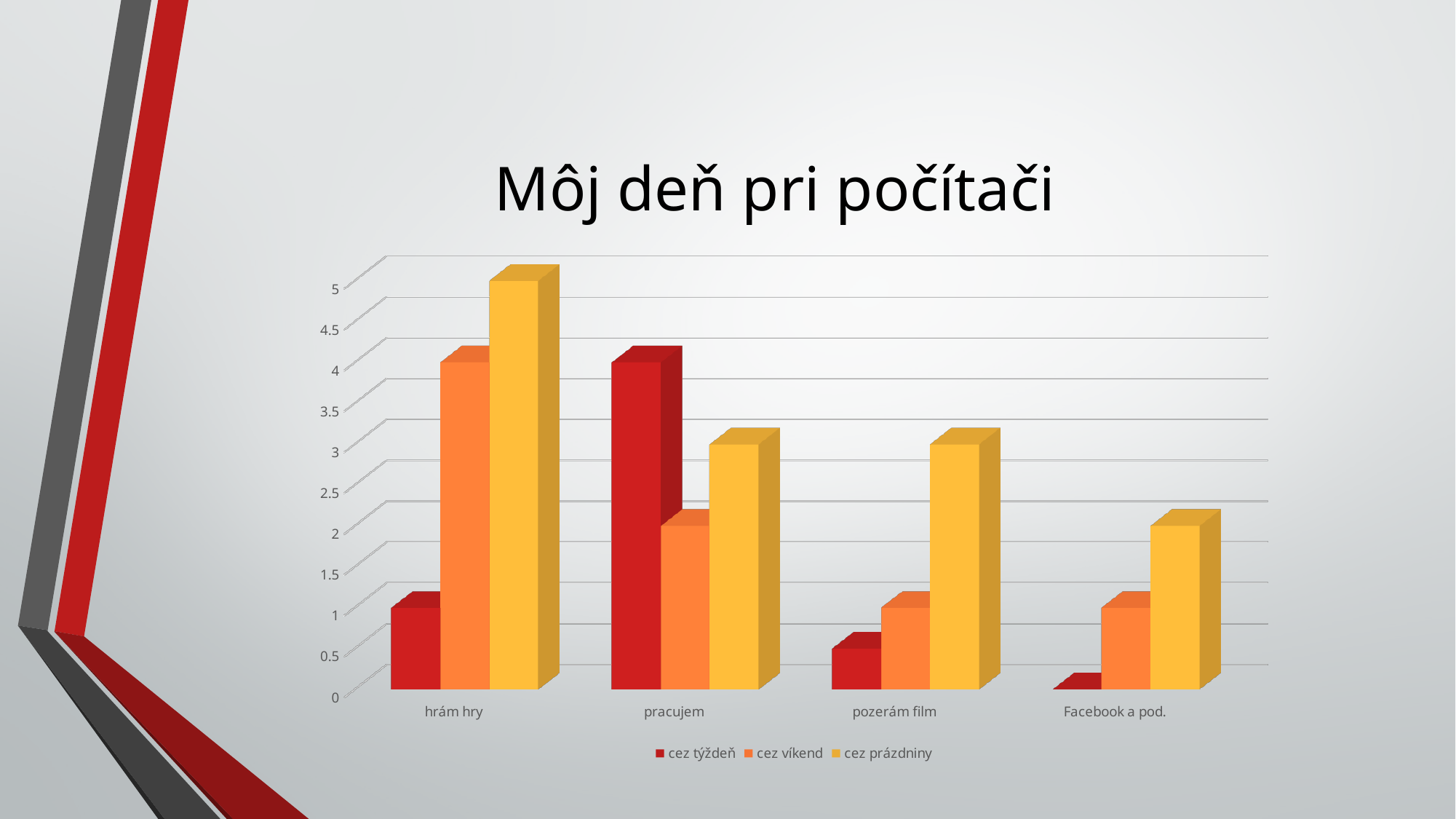
What kind of chart is shown on the slide? bar chart Is the value for 'cez víkend' in the 'pracujem' category greater or less than 3? less In the 'Facebook a pod.' category, which is larger: 'cez víkend' or 'cez prázdniny'? cez prázdniny Which category has the highest value for the 'cez týždeň' series? pracujem Is the value for 'cez prázdniny' in the 'hrám hry' category greater or less than 4? greater Is the value for 'cez týždeň' in the 'pozerám film' category greater or less than 1? less How many series does the legend list? 3 Which category has the lowest value for the 'cez týždeň' series? Facebook a pod. In the 'pracujem' category, which is larger: 'cez týždeň' or 'cez víkend'? cez týždeň How many categories are shown on the x axis? 4 Which category has the highest value for the 'cez prázdniny' series? hrám hry What is the title of the chart? Môj deň pri počítači